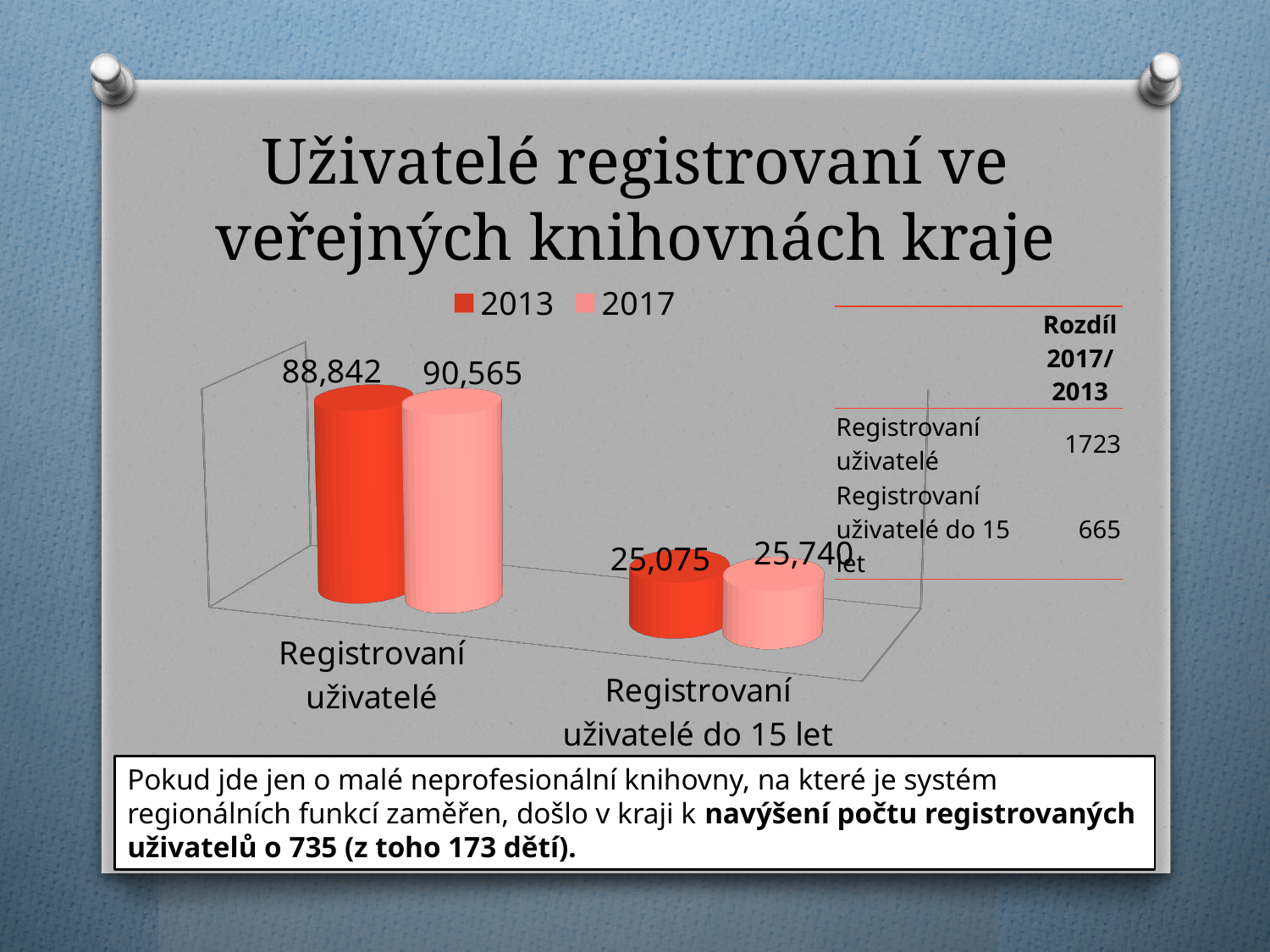
What is the value for 2017 for 'Registrovaní uživatelé'? 90,565 What is the difference between the 2017 and 2013 values for 'Registrovaní uživatelé do 15 let'? 665 How many series does the chart legend list? 2 What is the value for 2017 for 'Registrovaní uživatelé do 15 let'? 25,740 Which category has the lowest value in the 2013 series? Registrovaní uživatelé do 15 let What is the value for 2013 for 'Registrovaní uživatelé do 15 let'? 25,075 What kind of chart is shown on the slide? Bar chart What is the difference between the 2017 and 2013 values for 'Registrovaní uživatelé'? 1,723 How many categories are shown on the x axis of the chart? 2 Which category has the highest value in the 2017 series? Registrovaní uživatelé What is the value for 2013 for 'Registrovaní uživatelé'? 88,842 For 'Registrovaní uživatelé', which is larger: the 2013 value or the 2017 value? 2017